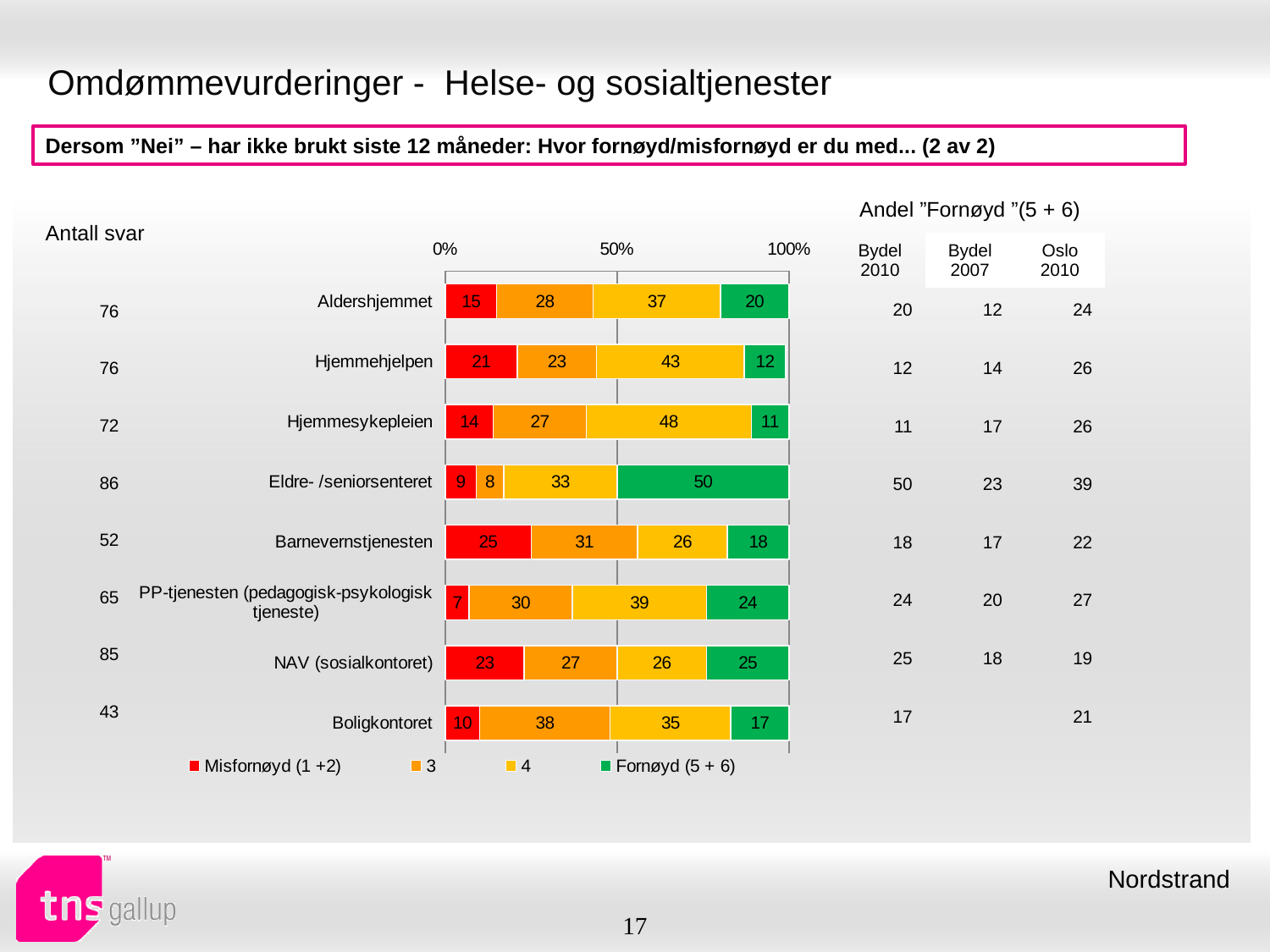
Which category has the highest Fornøyd (5 + 6) value? Eldre- /seniorsenteret How many series does the chart legend list? 4 What is the total of the stacked bar for Aldershjemmet? 100 What is the Fornøyd (5 + 6) value for Eldre- /seniorsenteret? 50 Which colour represents the Fornøyd (5 + 6) series in the chart? green What is the value of series 4 for Hjemmesykepleien? 48 What is the difference between the Fornøyd (5 + 6) values for NAV (sosialkontoret) and Boligkontoret? 8 What is the Misfornøyd (1 +2) value for Barnevernstjenesten? 25 What kind of chart is shown on the slide? stacked bar chart Which is larger: the Misfornøyd (1 +2) value for Hjemmehjelpen or for Aldershjemmet? Hjemmehjelpen Which category has the lowest Fornøyd (5 + 6) value? Hjemmesykepleien How many categories (services) are plotted in the chart? 8